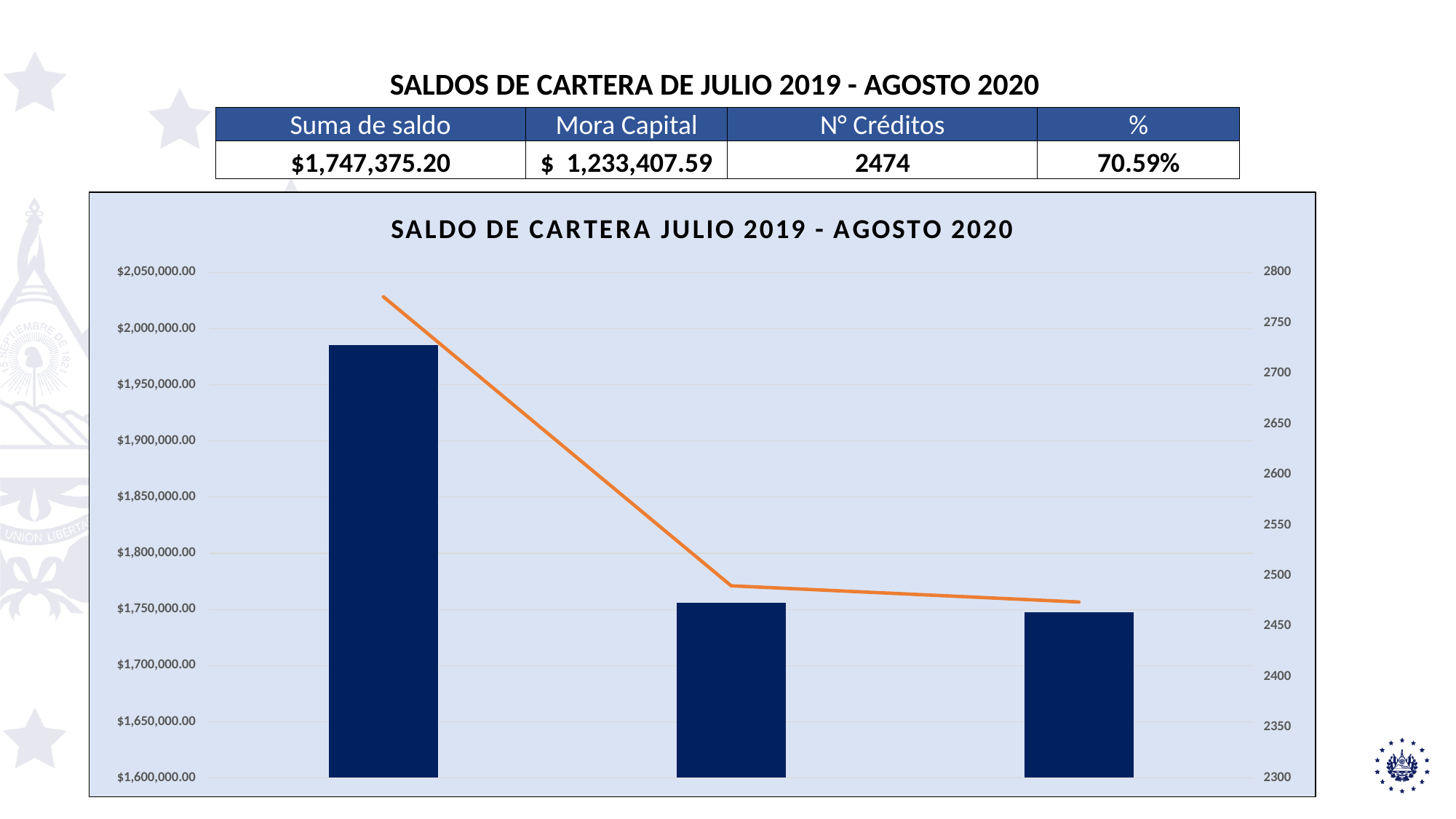
Do the bar values rise or fall from left to right across the chart? Fall How many bars are plotted in the chart? 3 Is the value of the rightmost bar greater or less than $1,700,000.00? greater Is the value of the leftmost bar greater or less than $1,950,000.00? greater Does the orange line rise or fall from left to right? Fall What is the title of the chart? SALDO DE CARTERA JULIO 2019 - AGOSTO 2020 What kind of chart is shown on the slide? A bar chart with a line Which is larger, the leftmost bar or the rightmost bar? The leftmost bar Is the last point of the orange line greater or less than 2500 on the right axis? less Which bar is the tallest in the chart? The leftmost bar